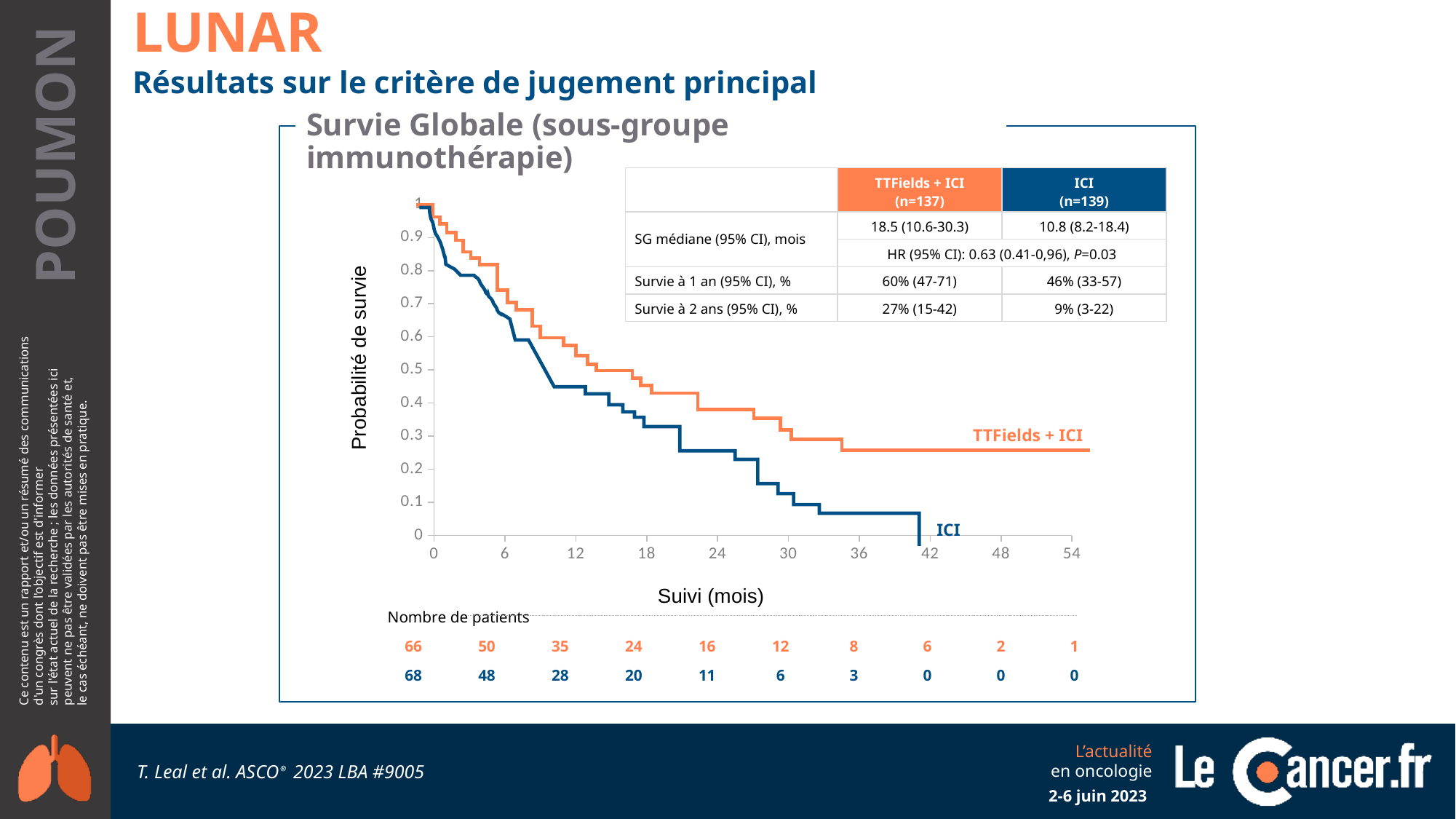
What kind of chart is shown on the slide? line chart (survival curve) At 24 months, is the survival probability for the ICI curve greater or less than 0.3? less What is the 2-year survival rate for the TTFields + ICI group? 27% (15-42) What is the median overall survival (SG médiane) in months for the TTFields + ICI group? 18.5 (10.6-30.3) What is the median overall survival (SG médiane) in months for the ICI group? 10.8 (8.2-18.4) What is the hazard ratio (HR) shown in the table? 0.63 (0.41-0,96) How many series (treatment groups) are plotted on the survival chart? 2 Do the survival curves rise or fall as follow-up time (months) increases? fall What is the difference in the number of patients at risk at 12 months between the TTFields + ICI group (35) and the ICI group (28)? 7 What is the 1-year survival rate for the ICI group? 46% (33-57) How many patients were at risk at 0 months in the TTFields + ICI group? 66 Which group has the higher 2-year survival rate, TTFields + ICI or ICI? TTFields + ICI